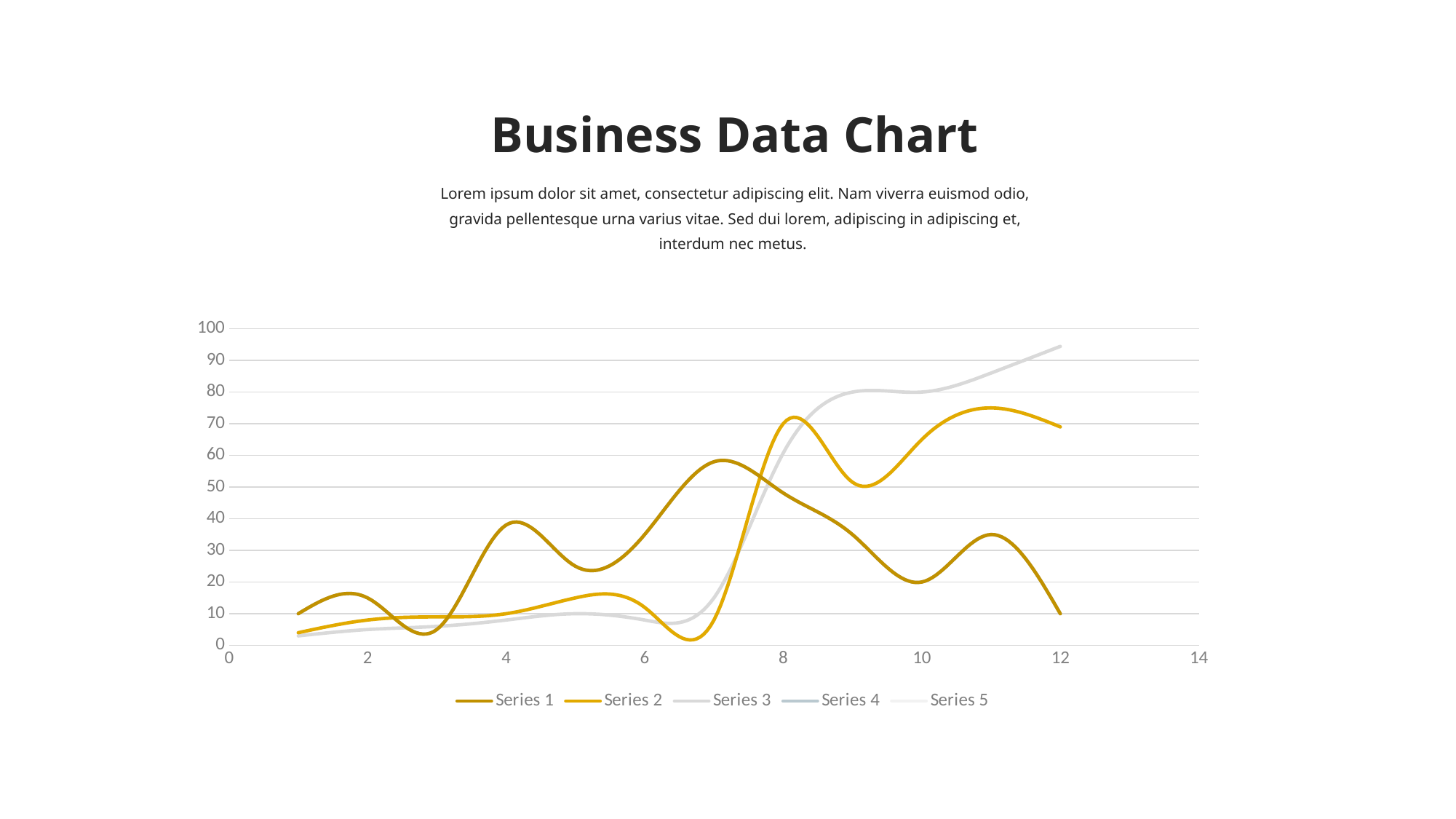
Is the value for Series 3 at x = 12 greater or less than 90? greater At x = 12, which is larger: Series 3 or Series 1? Series 3 Is the value for Series 3 at x = 6 greater or less than 10? less Does Series 3 generally rise or fall from x = 1 to x = 12? rise Is the value for Series 2 at x = 8 greater or less than 60? greater At x = 12, which is larger: Series 3 or Series 2? Series 3 How many series does the legend list? 5 What kind of chart is shown on the slide? line chart What is the title of the slide containing the chart? Business Data Chart